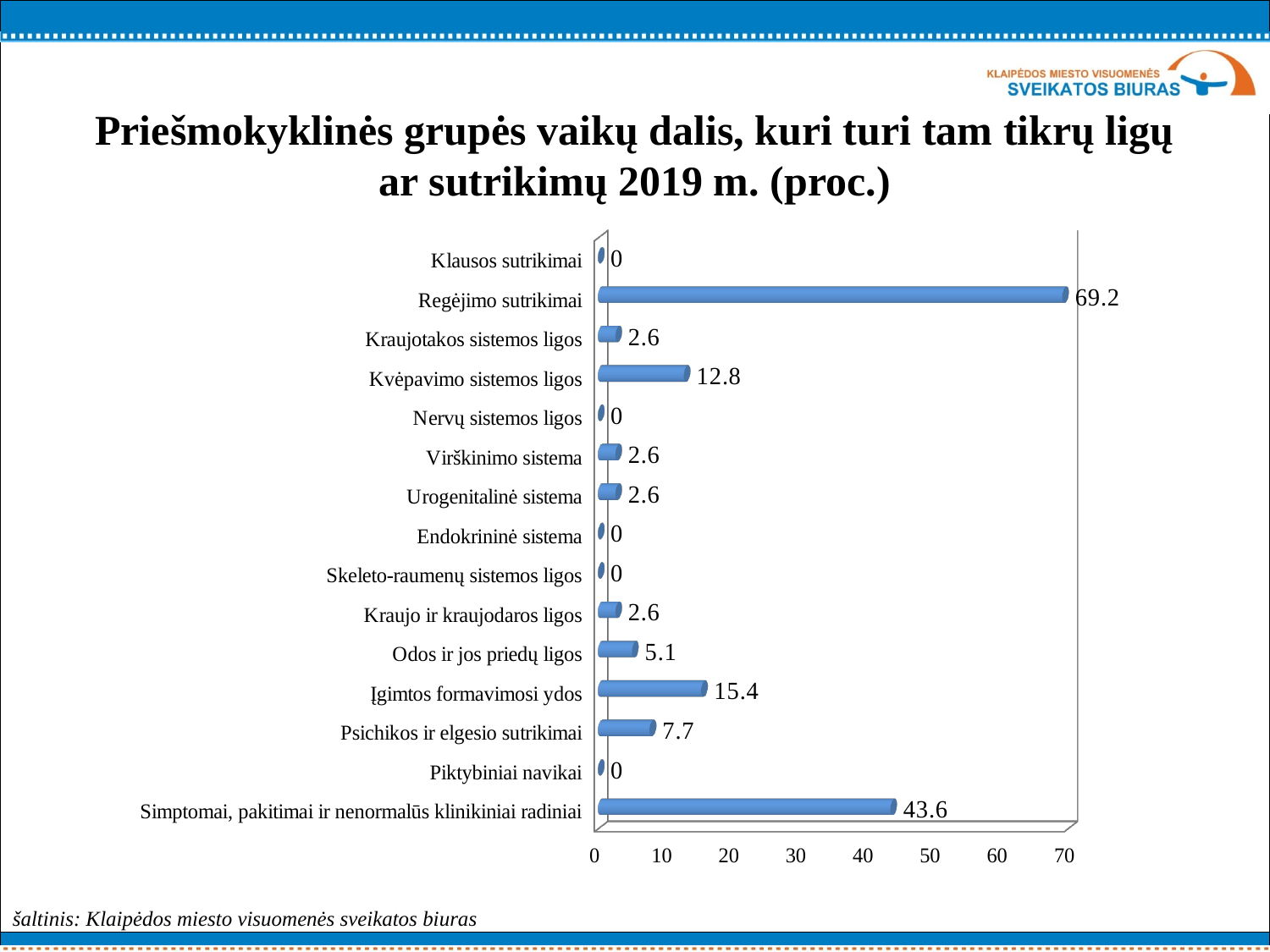
What is the value for Psichikos ir elgesio sutrikimai? 7.7 What is the difference between the values for Įgimtos formavimosi ydos and Odos ir jos priedų ligos? 10.3 What is the value for Kvėpavimo sistemos ligos? 12.8 How many categories have a value of 0? 5 What kind of chart is shown on the slide? Bar chart What is the difference between the values for Regėjimo sutrikimai and Simptomai, pakitimai ir nenormalūs klinikiniai radiniai? 25.6 How many categories are shown in the chart? 15 What is the value for Regėjimo sutrikimai? 69.2 Which is larger, the value for Kvėpavimo sistemos ligos or the value for Įgimtos formavimosi ydos? Įgimtos formavimosi ydos What is the value for Simptomai, pakitimai ir nenormalūs klinikiniai radiniai? 43.6 What is the highest tick value shown on the horizontal axis? 70 Which category has the highest value? Regėjimo sutrikimai